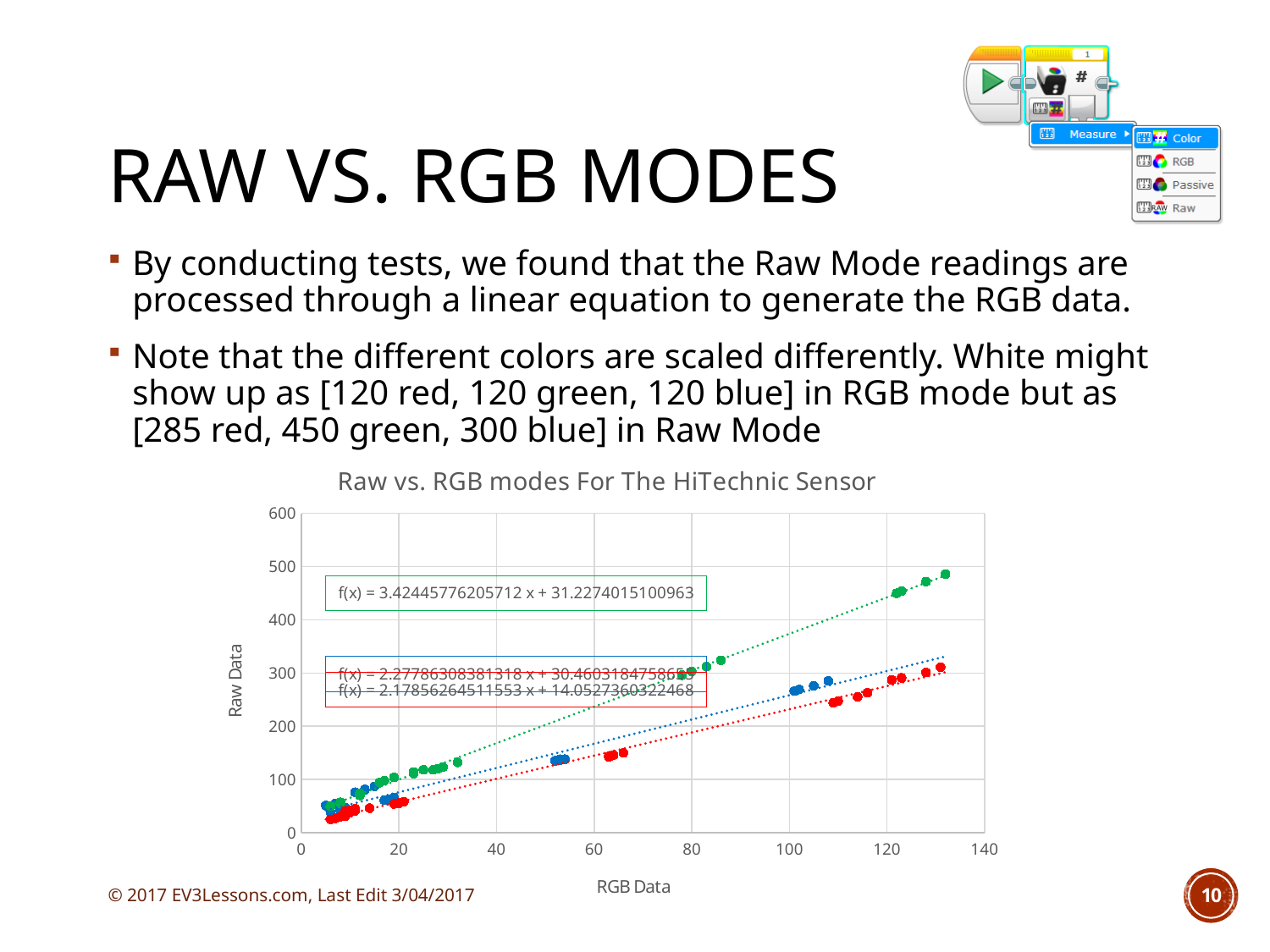
What kind of chart is shown on the slide? Scatter chart What is the label of the vertical axis of the chart? Raw Data At an RGB Data value of about 130, which series has the larger Raw Data value, green or red? Green Which colored series reaches the highest Raw Data value on the chart? Green At an RGB Data value of about 130, is the Raw Data value for the green series greater or less than 400? greater What is the title of the chart? Raw vs. RGB modes For The HiTechnic Sensor What is the maximum value shown on the vertical (Raw Data) axis? 600 Which colored series has the lowest Raw Data values at the right end of the chart? Red At an RGB Data value of about 100, is the Raw Data value for the blue series greater or less than 300? less What is the slope shown in the trendline equation for the green series? 3.42445776205712 At an RGB Data value of about 130, is the Raw Data value for the red series greater or less than 400? less Do the Raw Data values rise or fall as RGB Data increases along the x axis? Rise